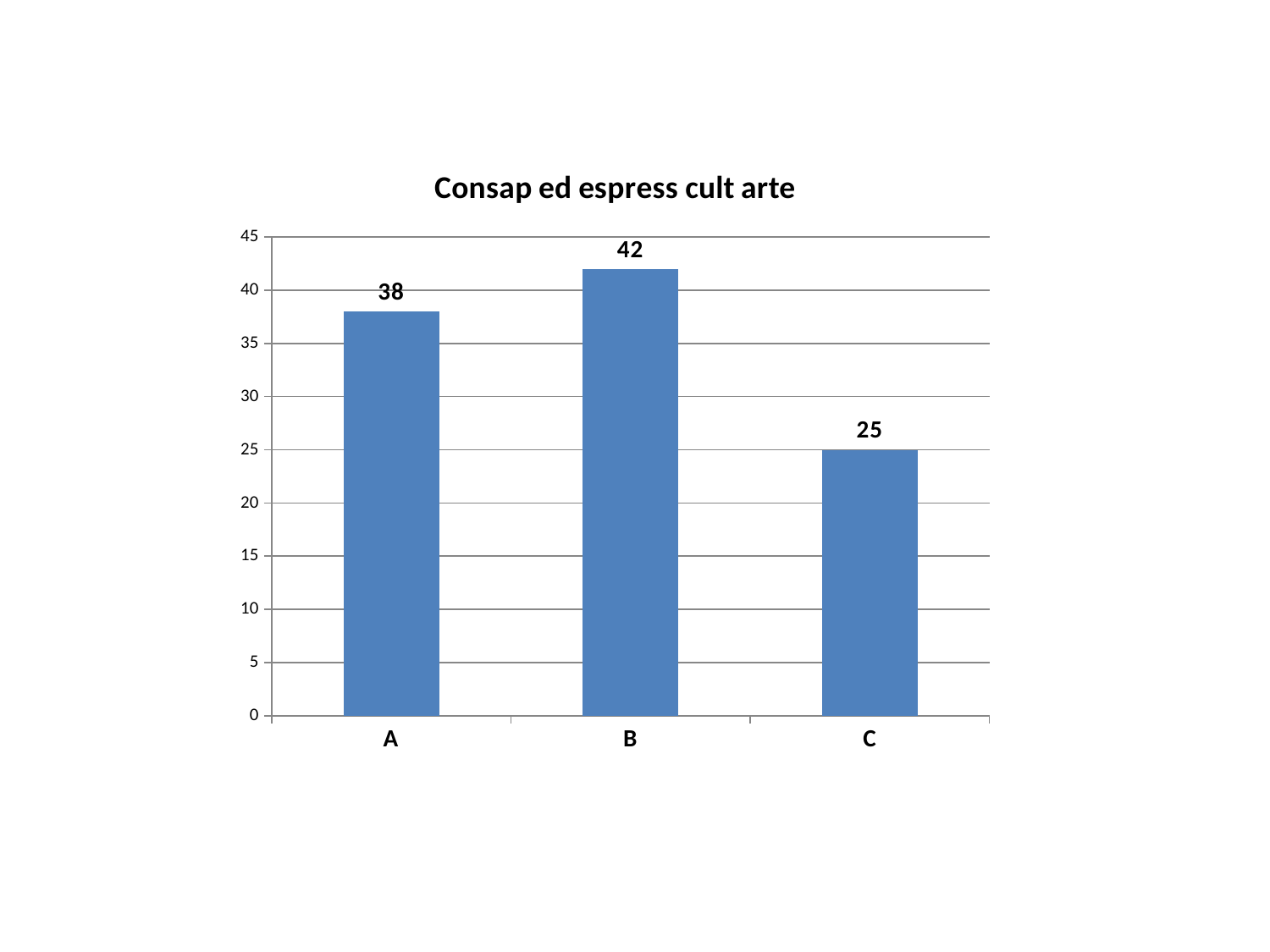
What is the value for category A? 38 Which category has the lowest value? C How many categories are shown on the x axis? 3 What kind of chart is shown on the slide? bar chart What is the title of the chart? Consap ed espress cult arte Which is larger, the value for A or the value for C? A Which category has the highest value? B What is the value for category B? 42 What is the difference between the values for B and A? 4 Is the value for B greater or less than 40? greater What is the difference between the values for A and C? 13 What is the value for category C? 25